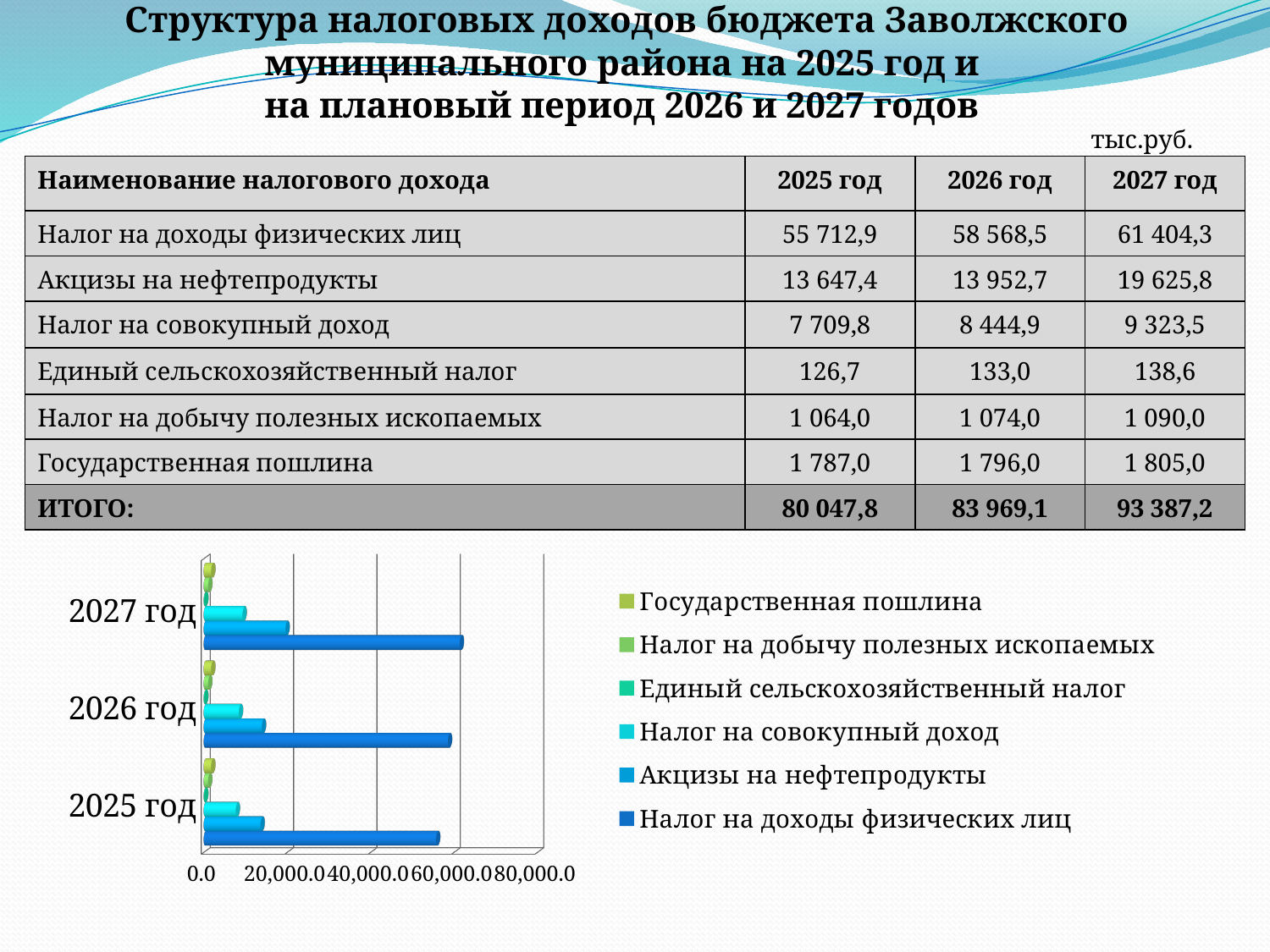
How many series does the chart legend list? 6 According to the slide, what is the value of Акцизы на нефтепродукты for 2027 год (тыс.руб.)? 19 625,8 Which year has the longest bar for Налог на доходы физических лиц? 2027 год Does the bar for Налог на доходы физических лиц rise or fall from 2025 год to 2027 год? rises Which series is listed last in the chart legend? Налог на доходы физических лиц Is the bar for Налог на совокупный доход in 2025 год greater or less than 20,000.0? less Which is larger: the Акцизы на нефтепродукты bar for 2027 год or for 2025 год? 2027 год What kind of chart is shown at the bottom of the slide? bar chart Is the bar for Налог на доходы физических лиц in 2027 год greater or less than 40,000.0? greater According to the slide, what is the value of Налог на доходы физических лиц for 2025 год (тыс.руб.)? 55 712,9 What is the difference between Налог на доходы физических лиц in 2027 год and in 2025 год (тыс.руб.)? 5 691,4 How many year categories are shown on the chart's vertical axis? 3